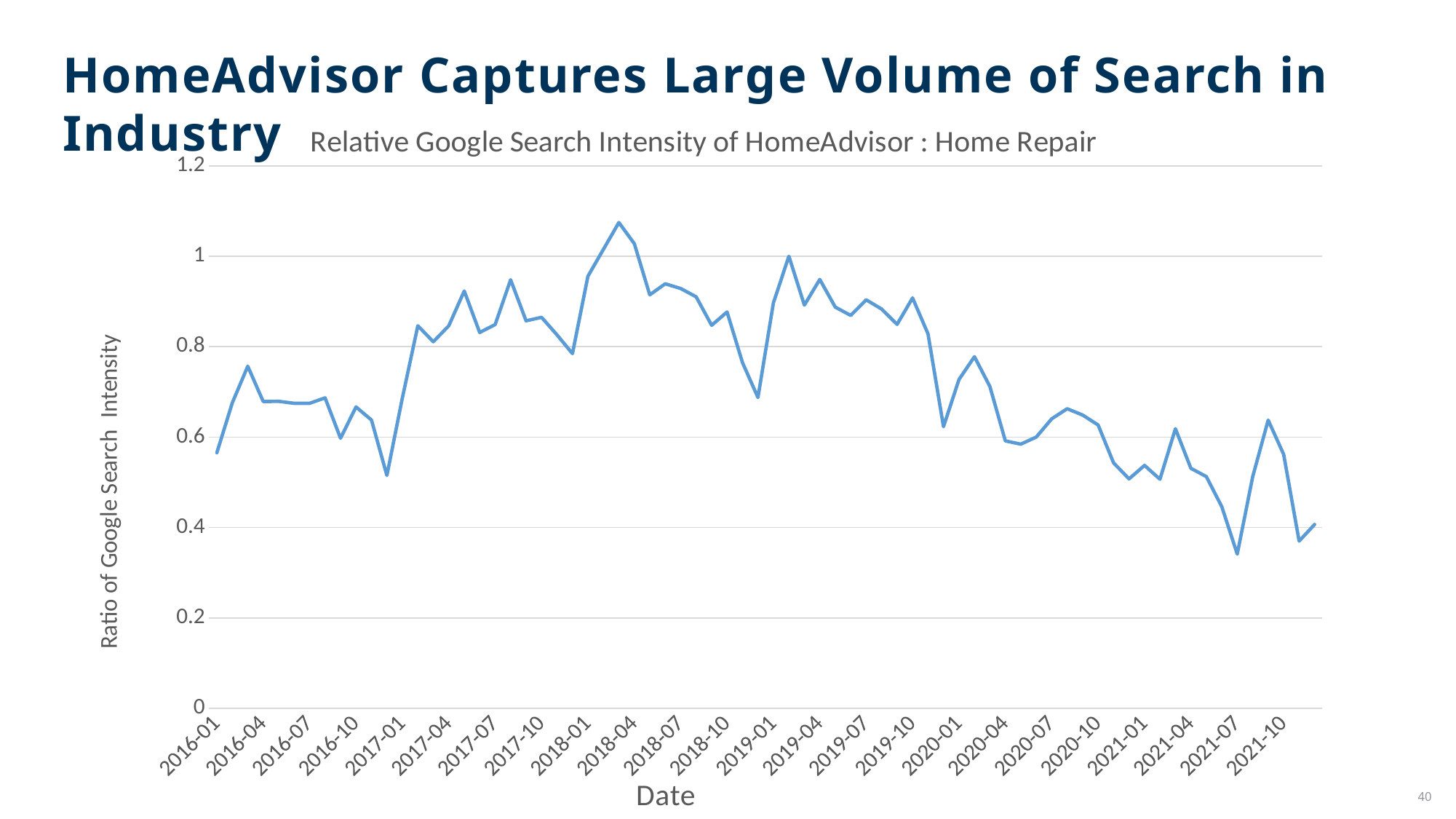
Does the line generally rise or fall between 2017-01 and 2018-04? rise Is the value at 2018-04 greater or less than 1? greater Which is larger, the value at 2019-01 or the value at 2019-04? 2019-04 Is the value at 2021-07 greater or less than 0.4? less Is the value at 2017-01 greater or less than 0.6? greater What is the label of the vertical axis of the chart? Ratio of Google Search Intensity What is the title of the chart? Relative Google Search Intensity of HomeAdvisor : Home Repair Around which x-axis date does the line reach its highest value? 2018-04 Around which x-axis date does the line reach its lowest value? 2021-07 Does the line generally rise or fall between 2020-01 and 2021-07? fall What kind of chart is shown on the slide? Line chart